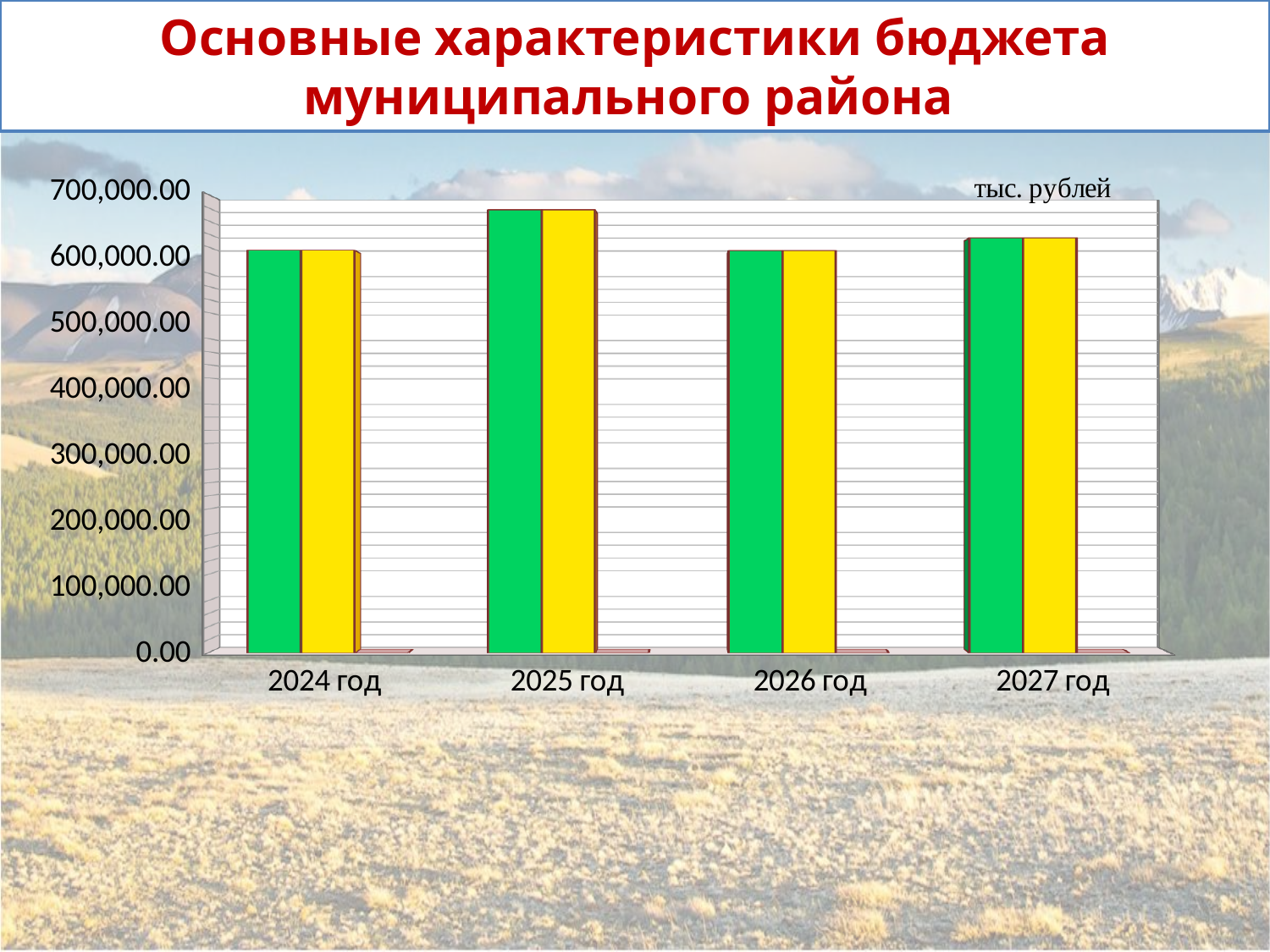
Is the value of the green bar for 2025 год greater or less than 600,000.00? greater Is the value of the yellow bar for 2025 год greater or less than 700,000.00? less How many bars are shown for each year in the chart? 2 Is the value of the green bar for 2024 год greater or less than 500,000.00? greater Which year has the highest bars in the chart? 2025 год How many years are shown on the x axis of the chart? 4 Which is larger: the green bar for 2025 год or the green bar for 2027 год? 2025 год Which is larger: the yellow bar for 2025 год or the yellow bar for 2024 год? 2025 год What kind of chart is shown on the slide? bar chart What unit of measurement is indicated on the chart? тыс. рублей